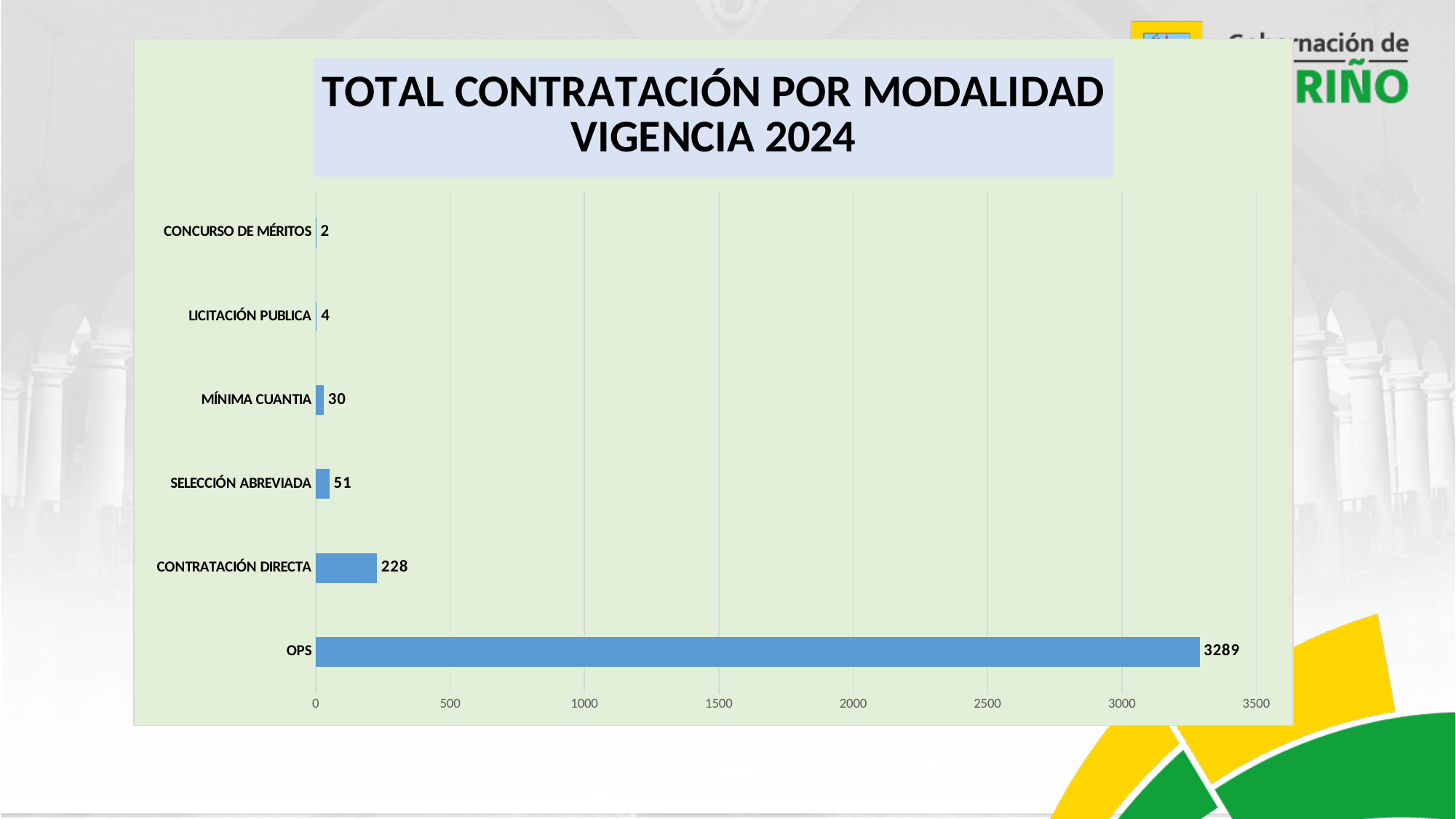
What is the title of the chart? TOTAL CONTRATACIÓN POR MODALIDAD VIGENCIA 2024 How many categories are shown in the chart? 6 What is the value for CONTRATACIÓN DIRECTA? 228 What is the value for OPS? 3289 Which category has the lowest value? CONCURSO DE MÉRITOS Which is larger, the value for SELECCIÓN ABREVIADA or the value for MÍNIMA CUANTIA? SELECCIÓN ABREVIADA What is the value for LICITACIÓN PUBLICA? 4 What is the value for MÍNIMA CUANTIA? 30 Is the value for OPS greater or less than 3000? greater What kind of chart is shown on the slide? bar chart Which category has the highest value? OPS What is the difference between the values for OPS and CONTRATACIÓN DIRECTA? 3061